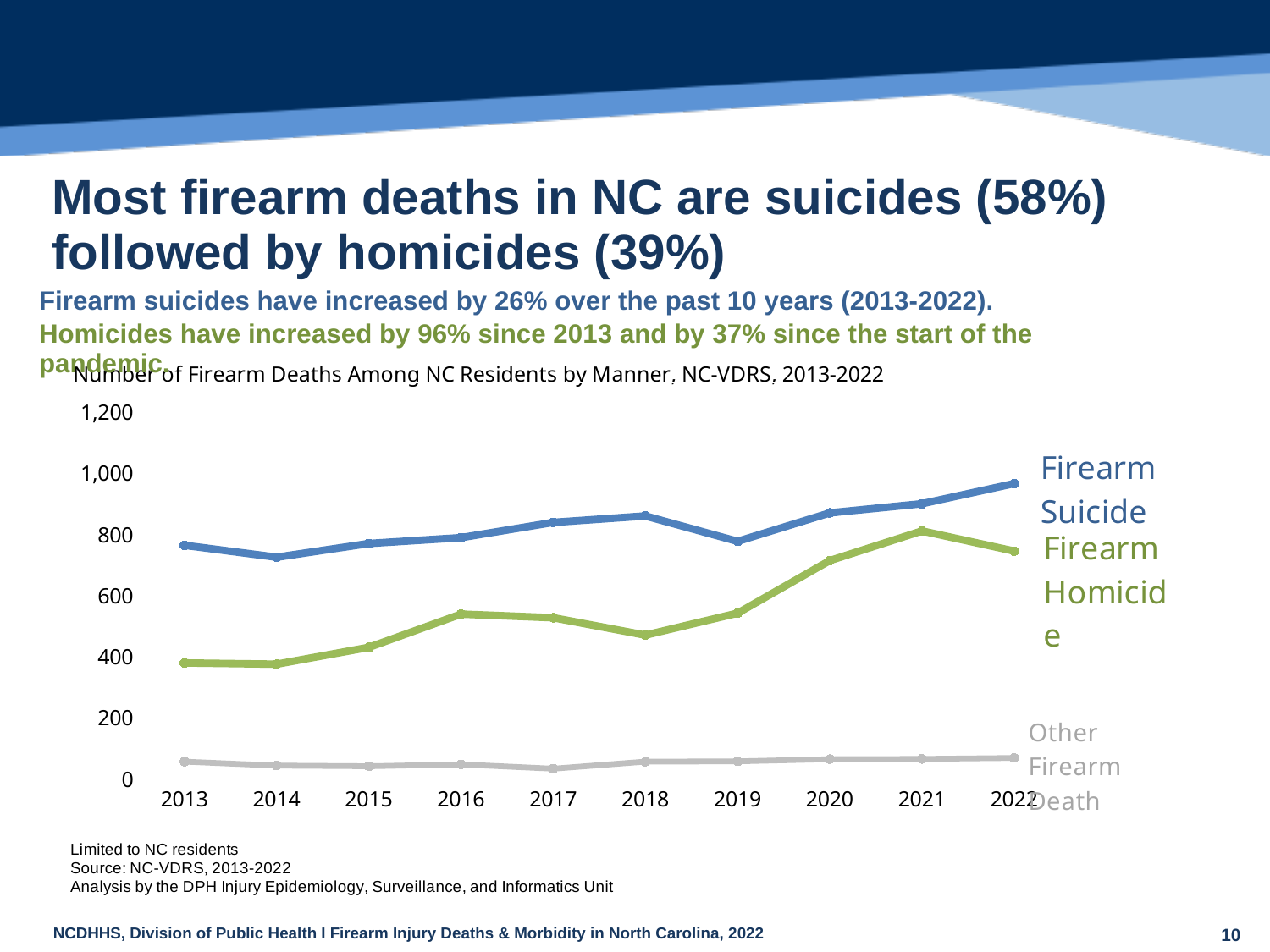
What kind of chart is shown on the slide? line chart In which year is the Firearm Homicide line at its highest? 2021 In which year is the Firearm Suicide line at its highest? 2022 Is the value for Other Firearm Death in 2022 greater or less than 200? less How many series does the chart's legend list? 3 How many years are plotted along the x axis? 10 What is the title of the chart? Number of Firearm Deaths Among NC Residents by Manner, NC-VDRS, 2013-2022 Does the Firearm Homicide line generally rise or fall from 2013 to 2021? rise Is the value for Firearm Suicide in 2022 greater or less than 800? greater In 2013, which series has the larger value, Firearm Suicide or Firearm Homicide? Firearm Suicide In which year is the Firearm Suicide line at its lowest? 2014 Is the value for Firearm Homicide in 2013 greater or less than 600? less